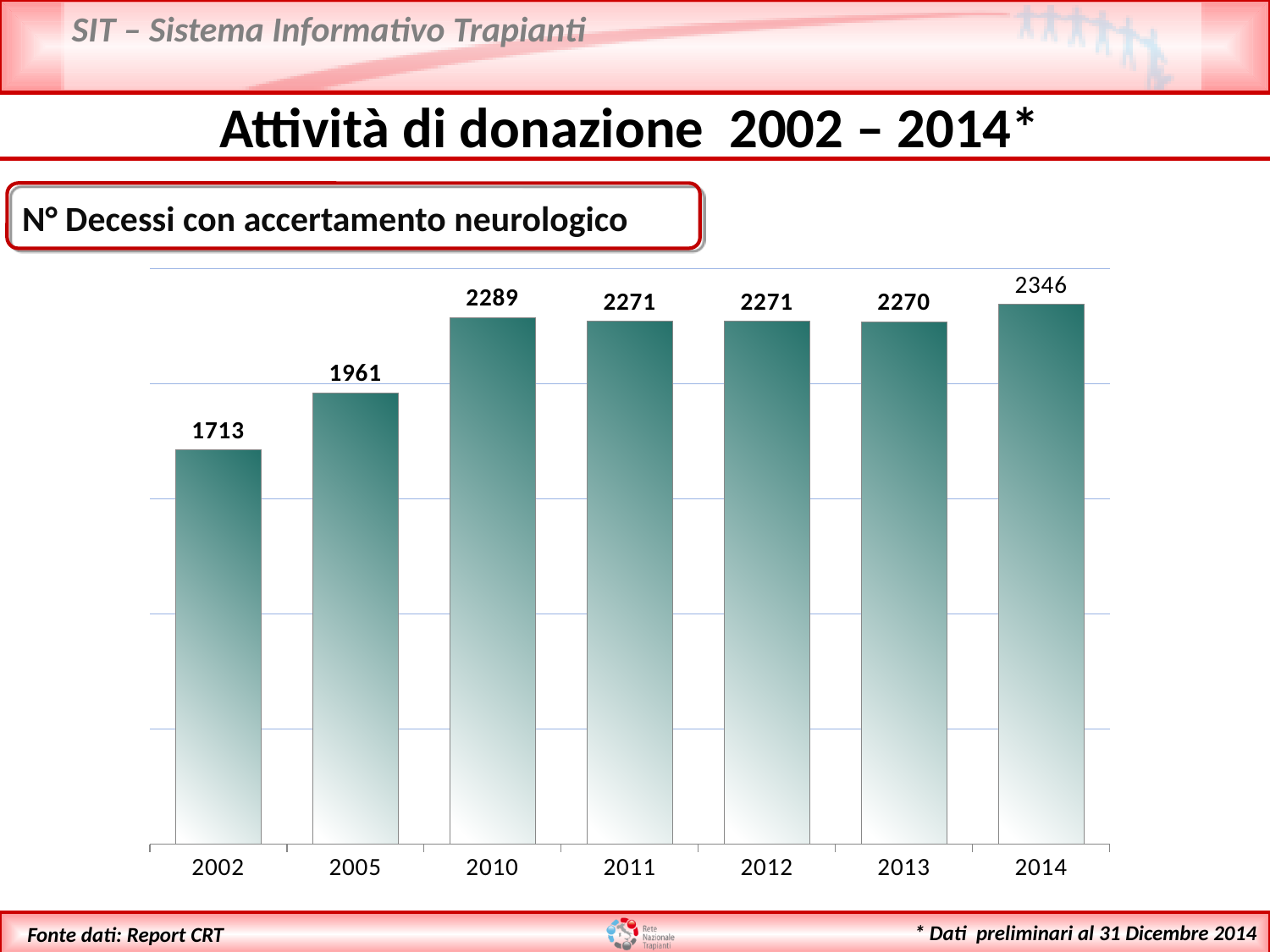
What value is shown for 2005? 1961 What kind of chart is shown on the slide? Bar chart Which year has the highest value? 2014 What value is shown for 2010? 2289 What is the difference between the values for 2005 and 2002? 248 Which is larger, the value for 2010 or the value for 2005? 2010 How many years are shown on the x axis? 7 Which year has the lowest value? 2002 What value is shown for 2014? 2346 What is the title of the chart? N° Decessi con accertamento neurologico What is the difference between the values for 2014 and 2002? 633 What is the number of deaths with neurological assessment (N° Decessi con accertamento neurologico) in 2002? 1713